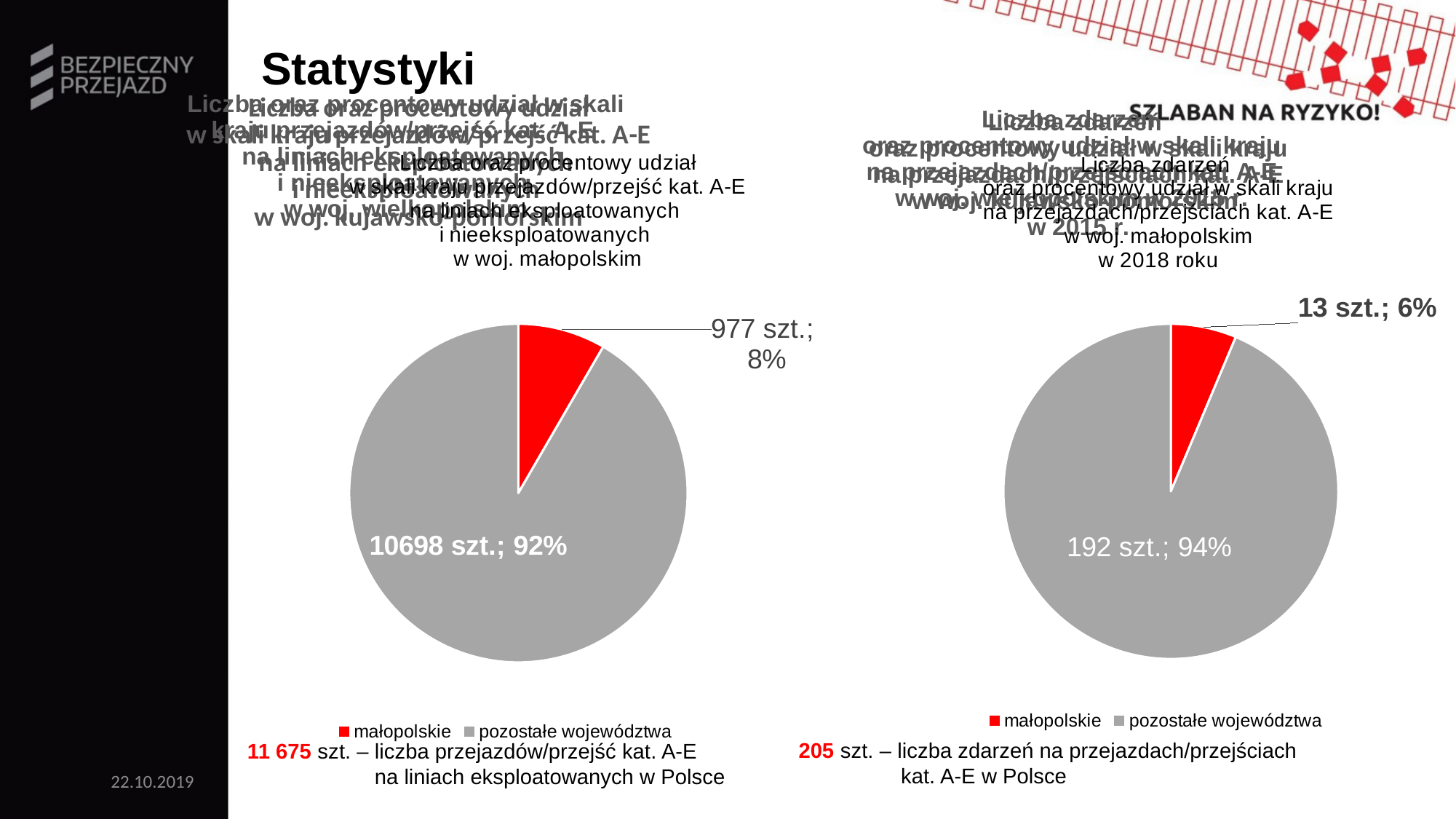
In the left pie chart, what value is shown for małopolskie? 977 szt.; 8% In the right pie chart, which colour represents małopolskie? red In the left pie chart, what share of the pie does małopolskie have? 8% What kind of chart is the left chart on the slide? pie chart In the right pie chart, what share of the pie does pozostałe województwa have? 94% In the left pie chart, what value is shown for pozostałe województwa? 10698 szt.; 92% In the right pie chart, what value is shown for pozostałe województwa? 192 szt.; 94% In the left pie chart, which slice is the largest? pozostałe województwa In the right pie chart, what value is shown for małopolskie? 13 szt.; 6% In the left pie chart, what is the difference in szt. between pozostałe województwa and małopolskie? 9721 szt. In the right pie chart, which slice is the smallest? małopolskie How many slices does the right pie chart have? 2